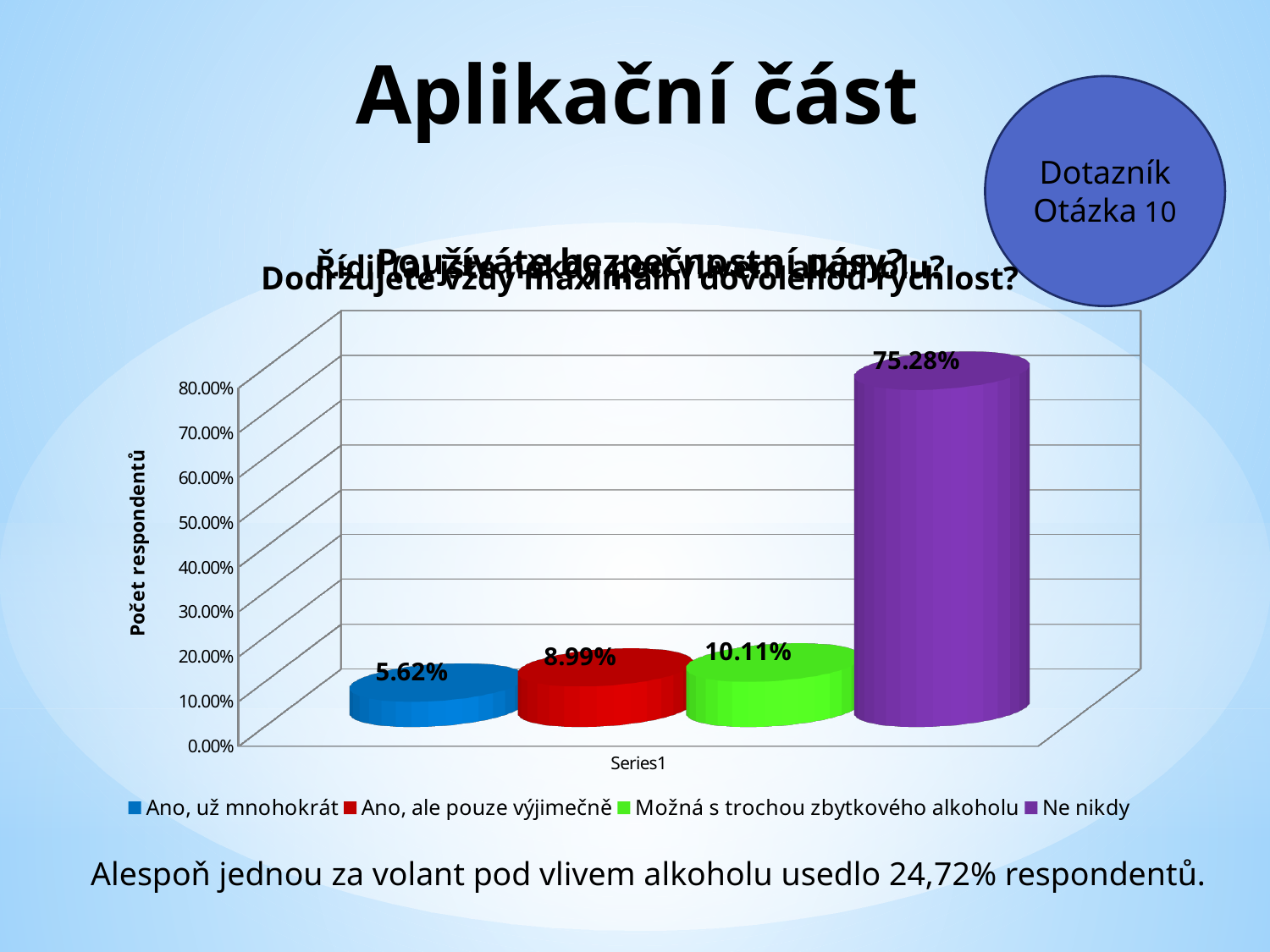
What is the value for "Možná s trochou zbytkového alkoholu"? 10.11% Which is larger, the value for "Ano, ale pouze výjimečně" or the value for "Ano, už mnohokrát"? Ano, ale pouze výjimečně Which legend entry has the lowest value? Ano, už mnohokrát Is the value for "Ne nikdy" greater or less than 70.00%? greater What is the value for "Ano, už mnohokrát"? 5.62% What kind of chart is shown on the slide? bar chart What is the value for "Ne nikdy"? 75.28% Which legend entry has the highest value? Ne nikdy What is the difference between the values for "Ne nikdy" and "Možná s trochou zbytkového alkoholu"? 65.17% How many series does the legend list? 4 What is the value for "Ano, ale pouze výjimečně"? 8.99% What is the label of the vertical axis? Počet respondentů